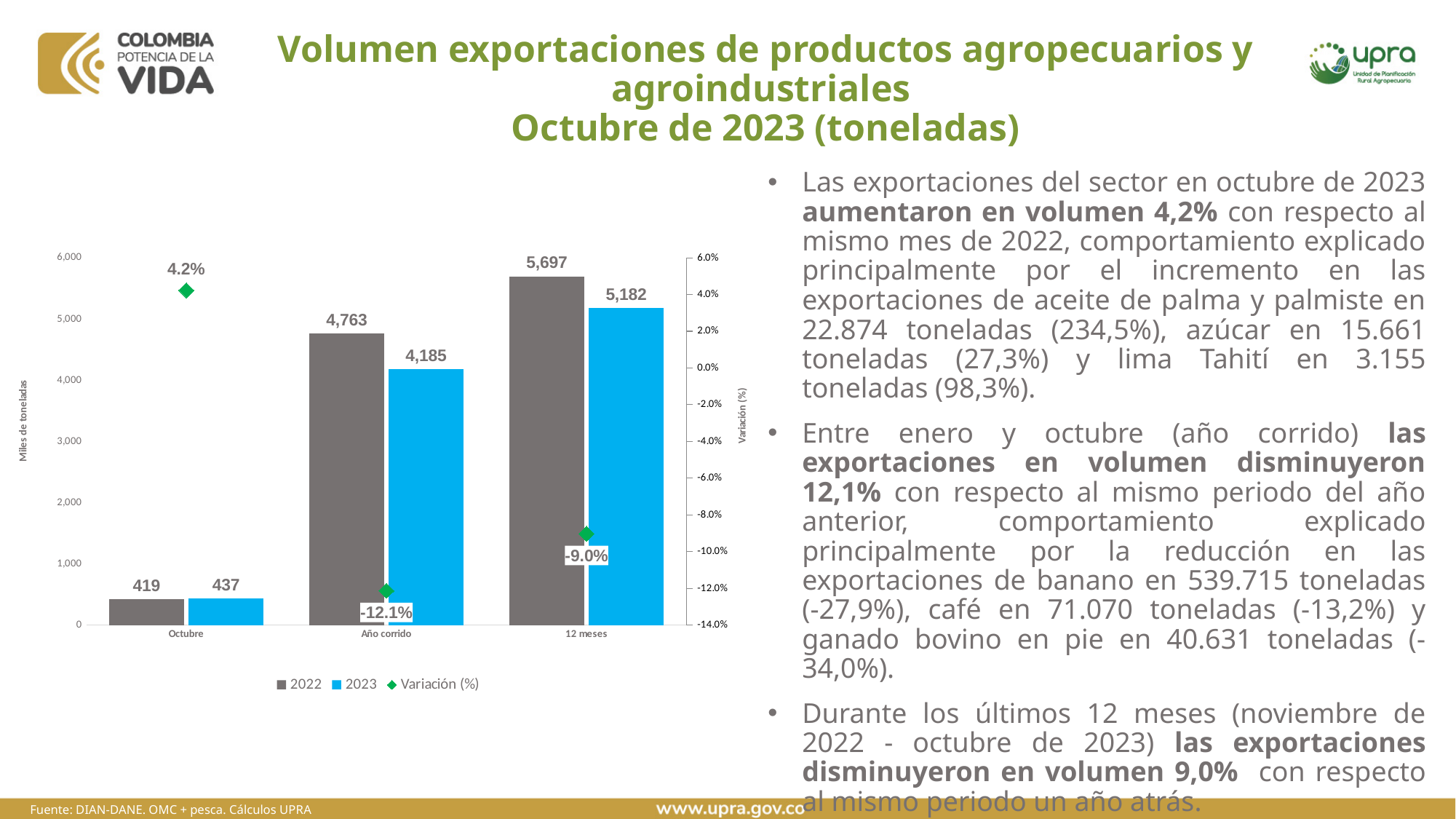
What is the difference between the 2022 and 2023 values for 12 meses? 515 What is the 2022 value for Octubre? 419 What is the Variación (%) value for Año corrido? -12.1% What is the 2022 value for 12 meses? 5,697 Is the 2023 value for Año corrido greater or less than 4,000? greater Which is larger for Octubre, the 2022 value or the 2023 value? 2023 How many categories are shown on the x axis? 3 How many series does the legend list? 3 Which category has the lowest 2022 value? Octubre Which category has the highest 2023 value? 12 meses What is the 2023 value for Año corrido? 4,185 What is the label of the left vertical axis? Miles de toneladas